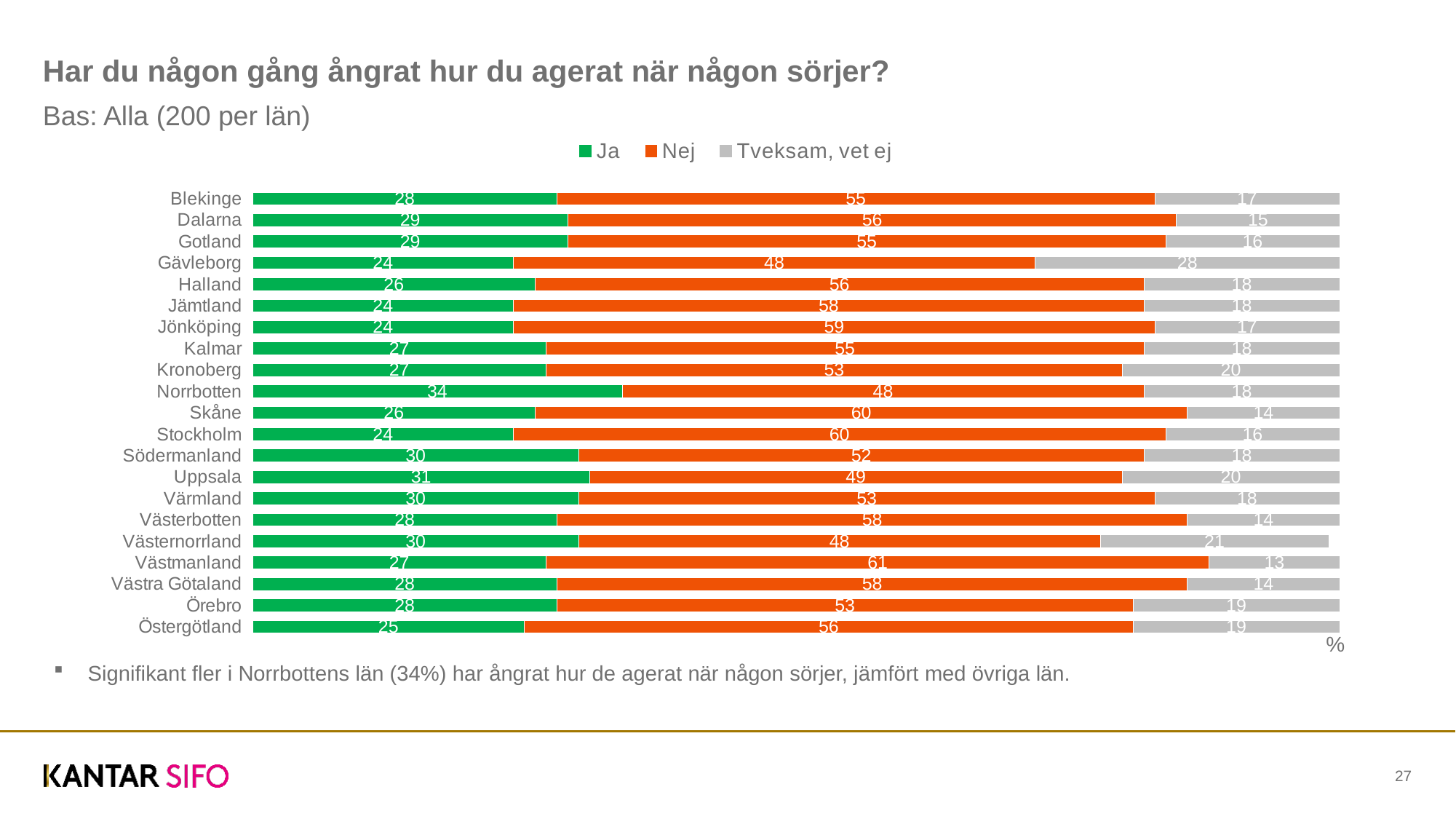
What is the 'Tveksam, vet ej' value for Gävleborg? 28 What is the 'Nej' value for Stockholm? 60 Which county has the lowest 'Tveksam, vet ej' value? Västmanland Which is larger, the 'Nej' value for Skåne or the 'Nej' value for Uppsala? Skåne What is the total of the stacked bar for Västernorrland? 99 Which county has the highest 'Nej' value? Västmanland How many series does the legend list? 3 How many counties (län) are shown in the chart? 21 What is the difference between the 'Ja' values for Norrbotten and Gävleborg? 10 Which county has the highest 'Ja' value? Norrbotten What is the 'Ja' value for Norrbotten? 34 What kind of chart is shown on the slide? Stacked bar chart